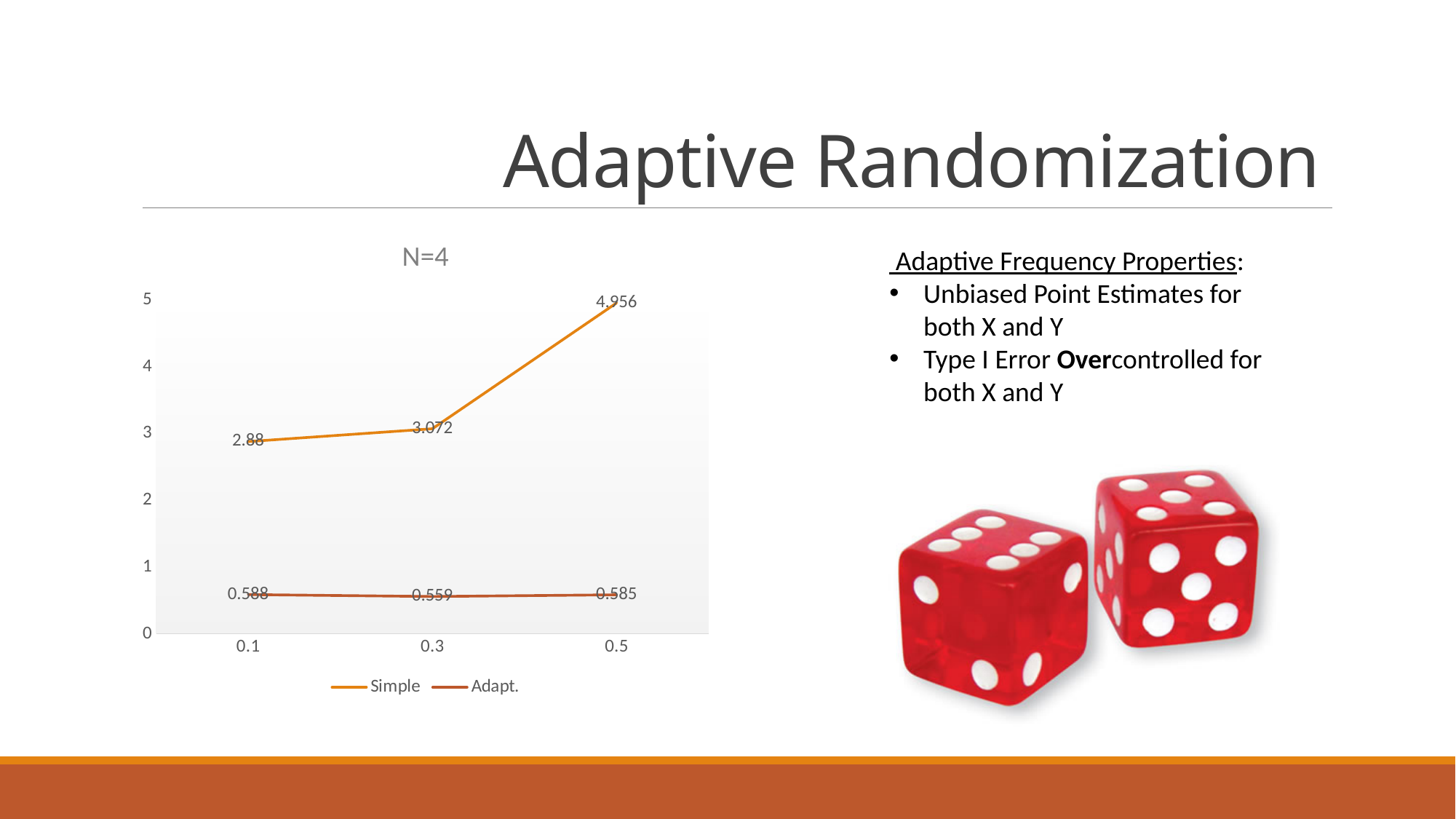
At which x-axis category is the Simple series highest? 0.5 What is the value of the Adapt. series at 0.5? 0.585 What is the difference between the Simple and Adapt. values at 0.5? 4.371 How many x-axis categories are plotted in the chart? 3 What is the title of the chart? N=4 How many series does the chart legend list? 2 Does the Simple series rise or fall from 0.1 to 0.5? rise What kind of chart is shown on the slide? line chart What is the value of the Adapt. series at 0.3? 0.559 What is the value of the Simple series at 0.5? 4.956 What is the value of the Simple series at 0.1? 2.88 At which x-axis category is the Adapt. series lowest? 0.3